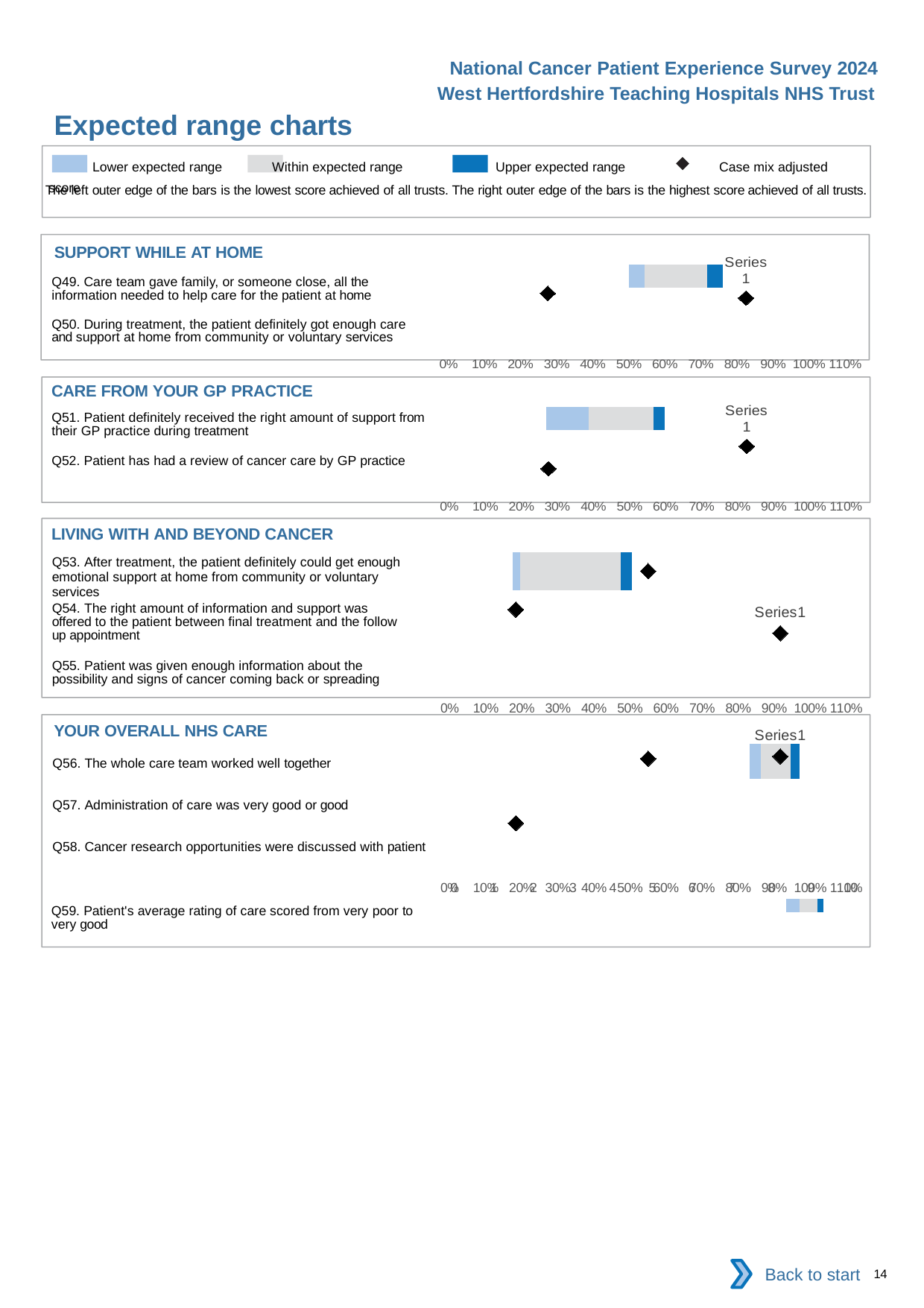
In the YOUR OVERALL NHS CARE chart, is the lowest case mix adjusted score marker greater or less than 30%? less What is the title of the slide? Expected range charts How many questions are listed in the SUPPORT WHILE AT HOME chart? 2 How many questions are listed in the LIVING WITH AND BEYOND CANCER chart? 3 How many entries does the legend at the top of the slide list? 4 In the LIVING WITH AND BEYOND CANCER chart, is the highest case mix adjusted score marker greater or less than 80%? greater What kind of chart is used in the SUPPORT WHILE AT HOME section? bar chart What is the highest value shown on the x axis of the CARE FROM YOUR GP PRACTICE chart? 110% How many questions are listed in the YOUR OVERALL NHS CARE chart? 4 In the SUPPORT WHILE AT HOME chart, is the highest case mix adjusted score marker greater or less than 70%? greater